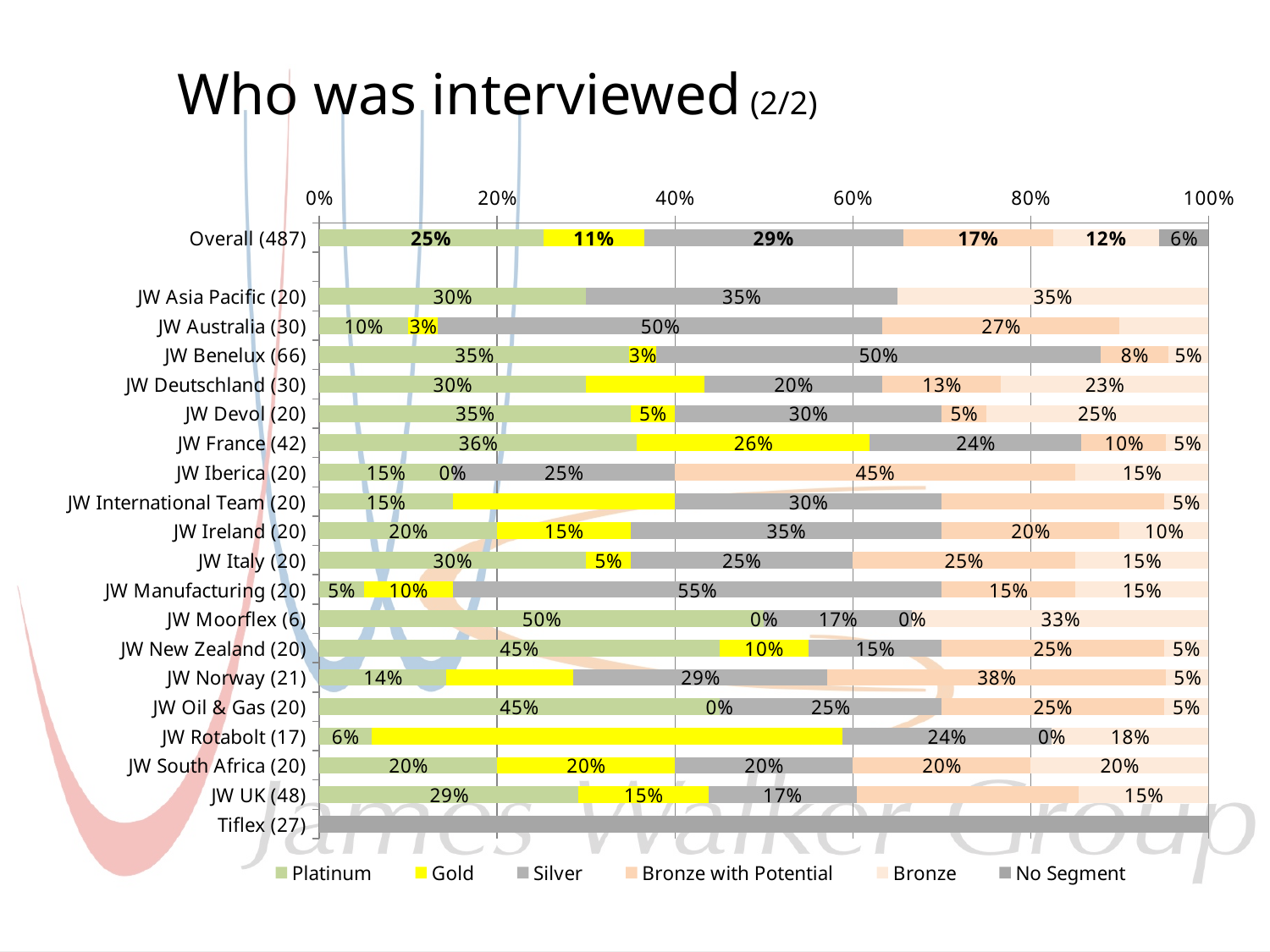
Which segment is the largest for Overall (487)? Silver What is the Silver share for JW Manufacturing (20)? 55% Which is larger for JW Australia (30): the Silver share or the Bronze with Potential share? Silver What is the Bronze share for JW Moorflex (6)? 33% What is the Platinum share for JW France (42)? 36% What colour represents the Gold series in the legend? Yellow What kind of chart is shown on the slide? Stacked bar chart How many categories (rows) are plotted on the chart? 20 How many series does the legend list? 6 What is the Bronze with Potential share for JW Iberica (20)? 45% What is the Silver share for Overall (487)? 29% Is the No Segment share for Tiflex (27) greater or less than 80%? greater